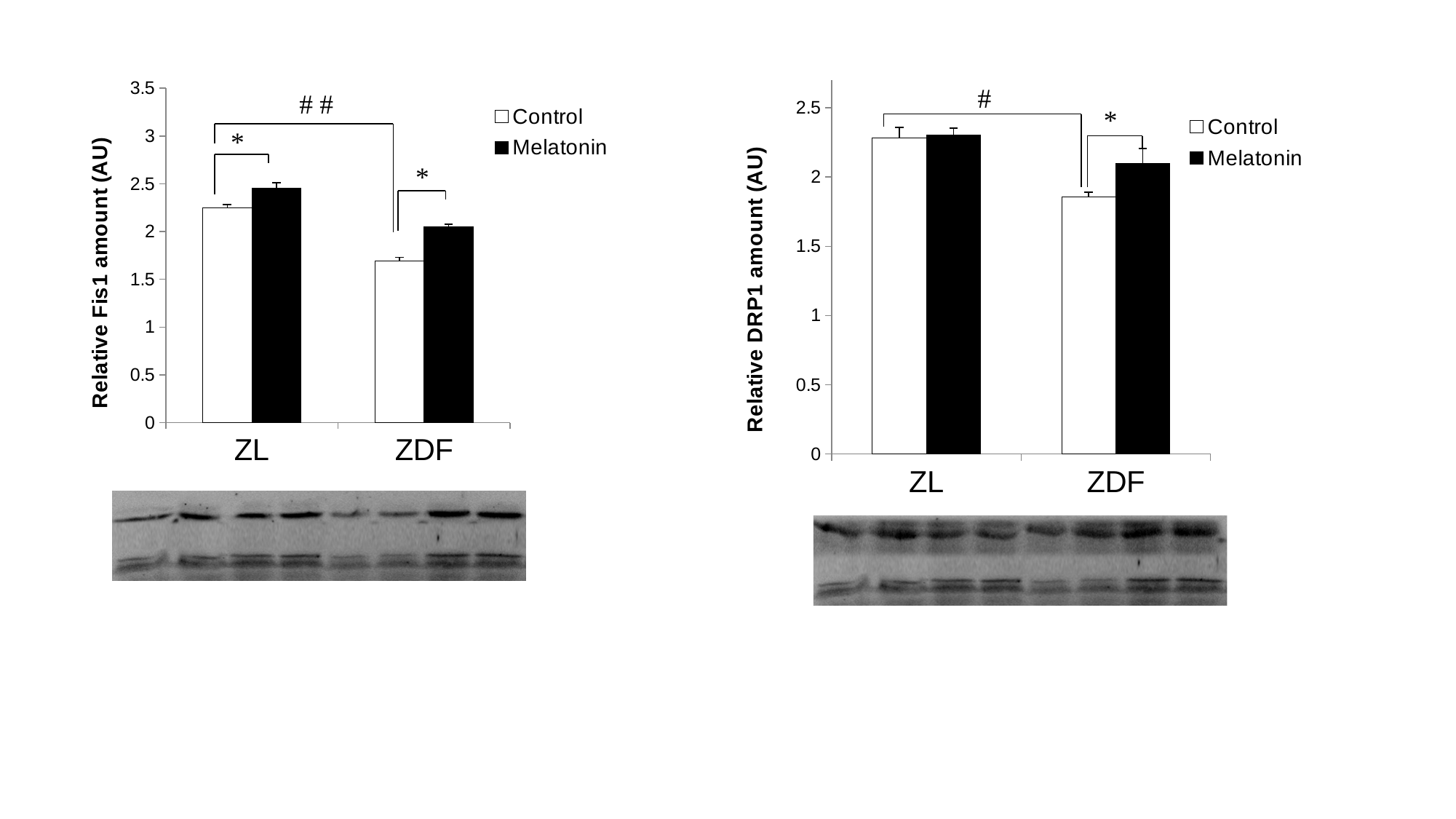
In the right chart (Relative DRP1 amount), which group and series has the lowest bar? ZDF Control What kind of chart is the left chart (Relative Fis1 amount)? bar chart In the left chart (Relative Fis1 amount), is the Melatonin value for ZL greater or less than 2? greater In the left chart (Relative Fis1 amount), which is larger for ZDF: Control or Melatonin? Melatonin What is the y-axis label of the right chart? Relative DRP1 amount (AU) How many series does the legend of the right chart (Relative DRP1 amount) list? 2 In the left chart (Relative Fis1 amount), is the Control value for ZDF greater or less than 2? less In the right chart (Relative DRP1 amount), is the Control value for ZDF greater or less than 2? less In the left chart (Relative Fis1 amount), which group and series has the lowest bar? ZDF Control In the right chart (Relative DRP1 amount), which is larger for ZDF: Control or Melatonin? Melatonin How many categories are shown on the x axis of the left chart (Relative Fis1 amount)? 2 In the left chart (Relative Fis1 amount), which group and series has the highest bar? ZL Melatonin